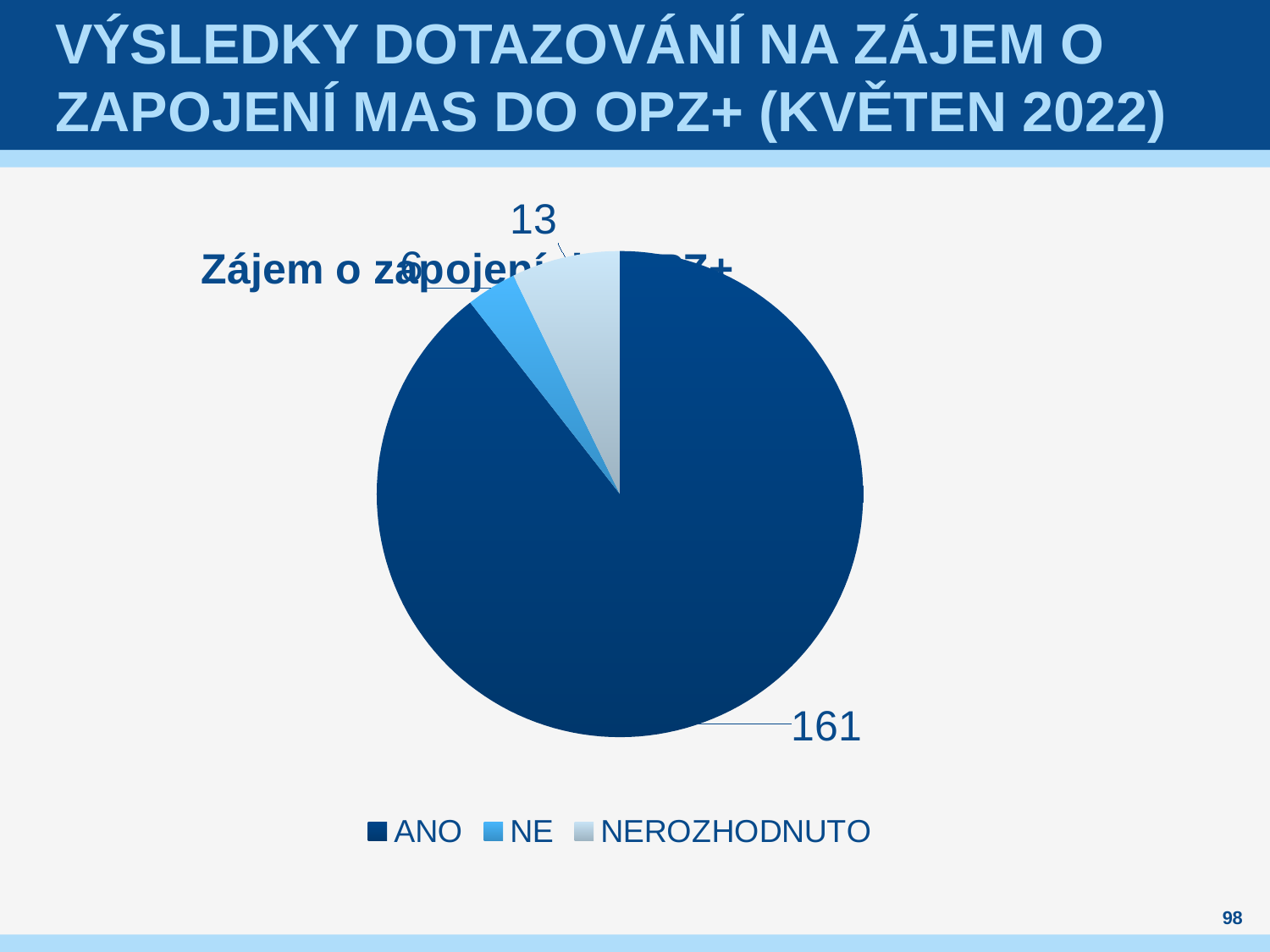
How many entries does the legend list? 3 Which is larger, the value for ANO or the value for NEROZHODNUTO? ANO What is the value for ANO in the pie chart? 161 What is the value for NEROZHODNUTO in the pie chart? 13 Which category has the smallest slice of the pie? NE What is the difference between the value for ANO and the value for NEROZHODNUTO? 148 Which category has the largest slice of the pie? ANO How many slices does the pie chart have? 3 What are the three legend entries of the pie chart? ANO, NE, NEROZHODNUTO Where is the legend placed relative to the pie chart? below the chart What kind of chart is shown on the slide? pie chart Which slice is larger, NE or NEROZHODNUTO? NEROZHODNUTO